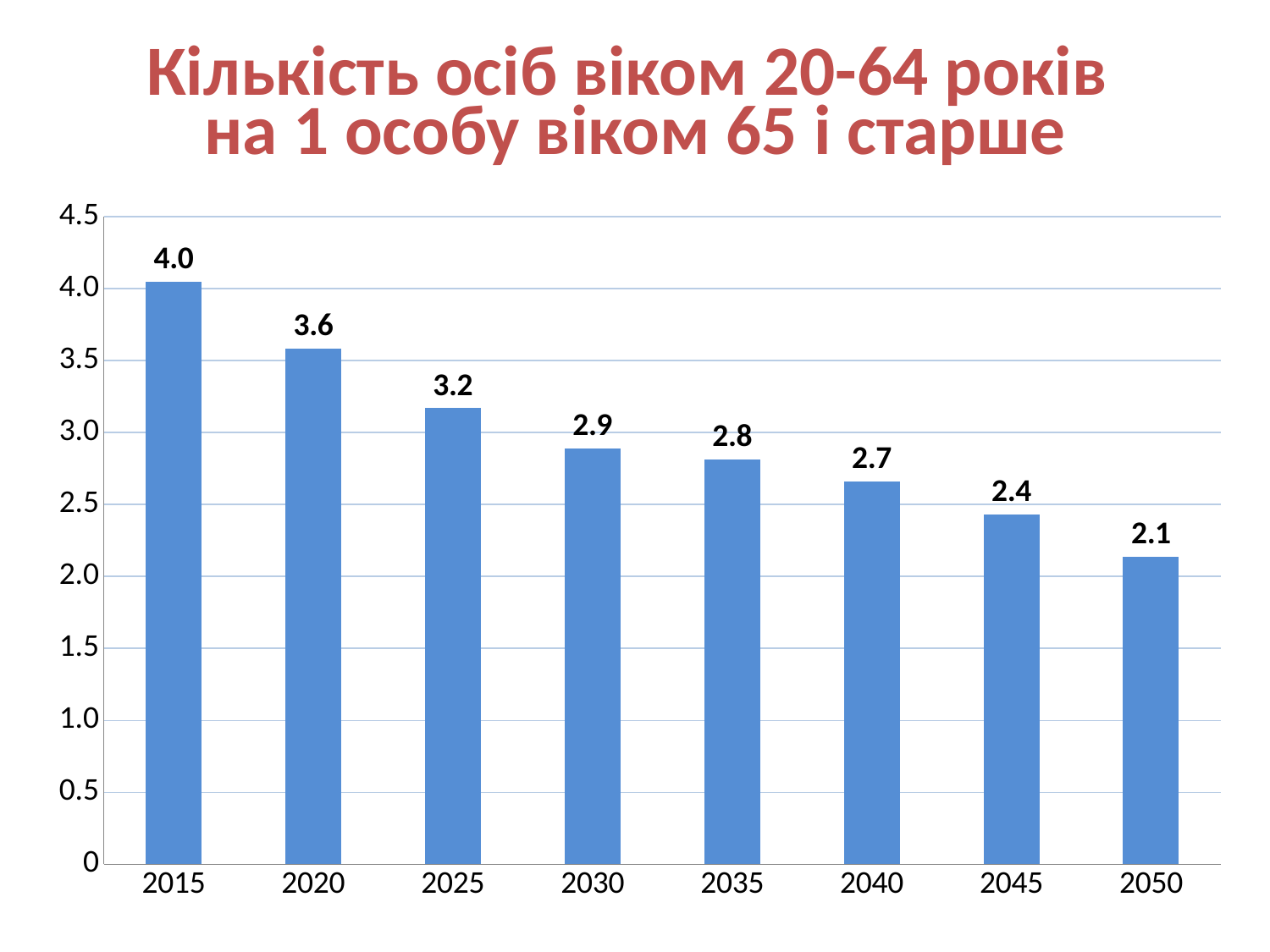
What kind of chart is shown? bar chart Is the value for 2025 greater or less than 3.0? greater What is the value for 2050? 2.1 Which is larger, the value for 2020 or the value for 2040? 2020 What is the title of the chart? Кількість осіб віком 20-64 років на 1 особу віком 65 і старше Which year has the lowest value? 2050 What is the value for 2015? 4.0 How many years are shown on the x axis? 8 Do the values rise or fall from 2015 to 2050? fall Which year has the highest value? 2015 What is the difference between the values for 2015 and 2050? 1.9 What is the value for 2035? 2.8